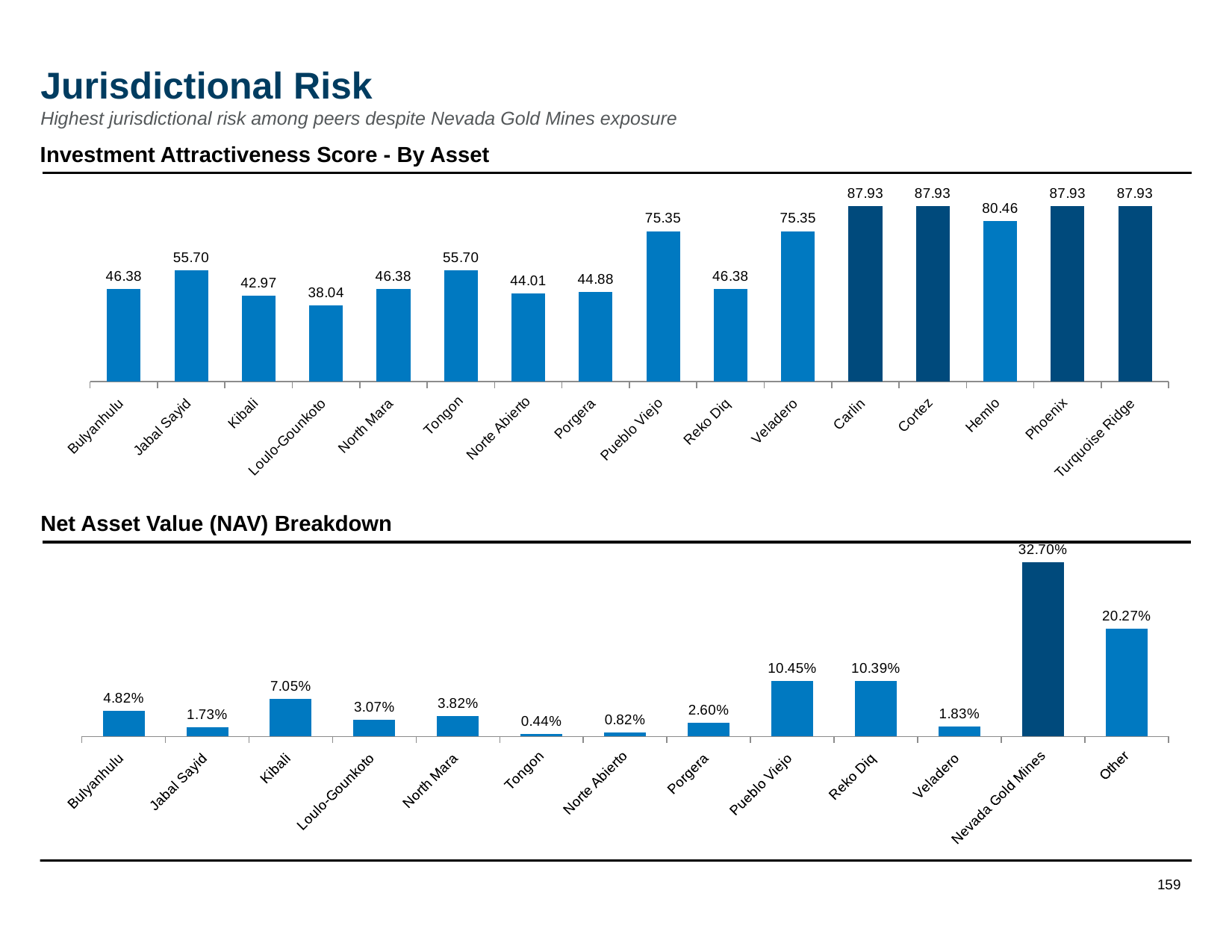
In the Net Asset Value (NAV) Breakdown chart, which category has the lowest value? Tongon In the Investment Attractiveness Score - By Asset chart, what is the score for Loulo-Gounkoto? 38.04 In the Net Asset Value (NAV) Breakdown chart, what is the value for Nevada Gold Mines? 32.70% In the Investment Attractiveness Score - By Asset chart, what is the score for Hemlo? 80.46 In the Investment Attractiveness Score - By Asset chart, what is the difference between the scores for Pueblo Viejo and Kibali? 32.38 What type of chart is the Net Asset Value (NAV) Breakdown chart? Bar chart In the Investment Attractiveness Score - By Asset chart, which has the higher score, Jabal Sayid or Porgera? Jabal Sayid In the Net Asset Value (NAV) Breakdown chart, which category has the highest value? Nevada Gold Mines How many assets are shown in the Investment Attractiveness Score - By Asset chart? 16 How many categories are shown in the Net Asset Value (NAV) Breakdown chart? 13 In the Net Asset Value (NAV) Breakdown chart, what is the difference between the values for Kibali and Bulyanhulu? 2.23% In the Investment Attractiveness Score - By Asset chart, which asset has the lowest score? Loulo-Gounkoto